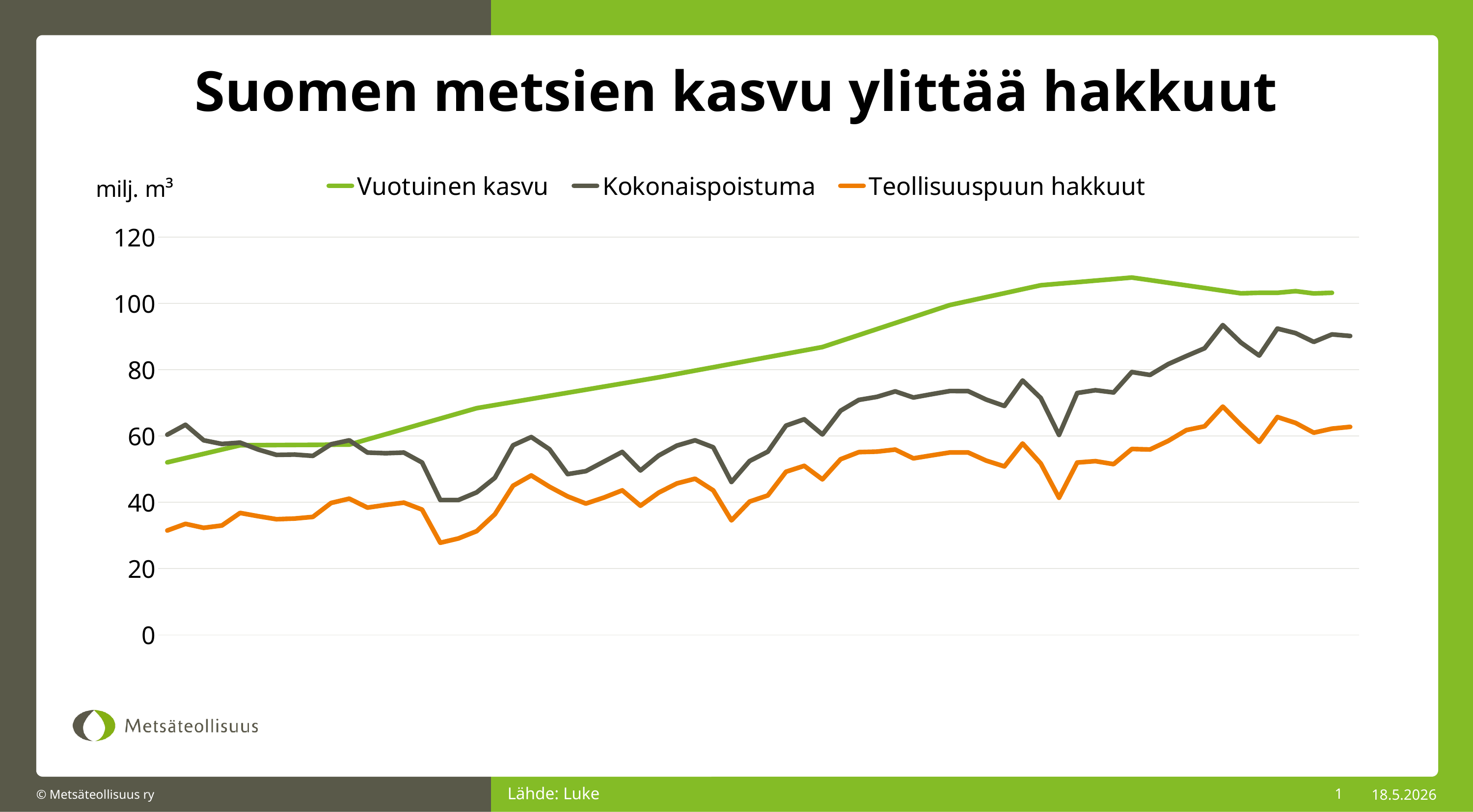
What is the title of the chart? Suomen metsien kasvu ylittää hakkuut At the right end of the chart, which is larger: Kokonaispoistuma or Teollisuuspuun hakkuut? Kokonaispoistuma Does the Vuotuinen kasvu line generally rise or fall from left to right? rise Which series has the lowest values at the right end of the chart? Teollisuuspuun hakkuut What unit is shown for the y axis? milj. m³ Which series has the highest values at the right end of the chart? Vuotuinen kasvu What kind of chart is shown on the slide? line chart How many series does the legend list? 3 Is the peak value of the Vuotuinen kasvu line greater or less than 100? greater Is the highest value of the Kokonaispoistuma line greater or less than 100? less Is the lowest value of the Teollisuuspuun hakkuut line greater or less than 40? less Which series is plotted in orange? Teollisuuspuun hakkuut